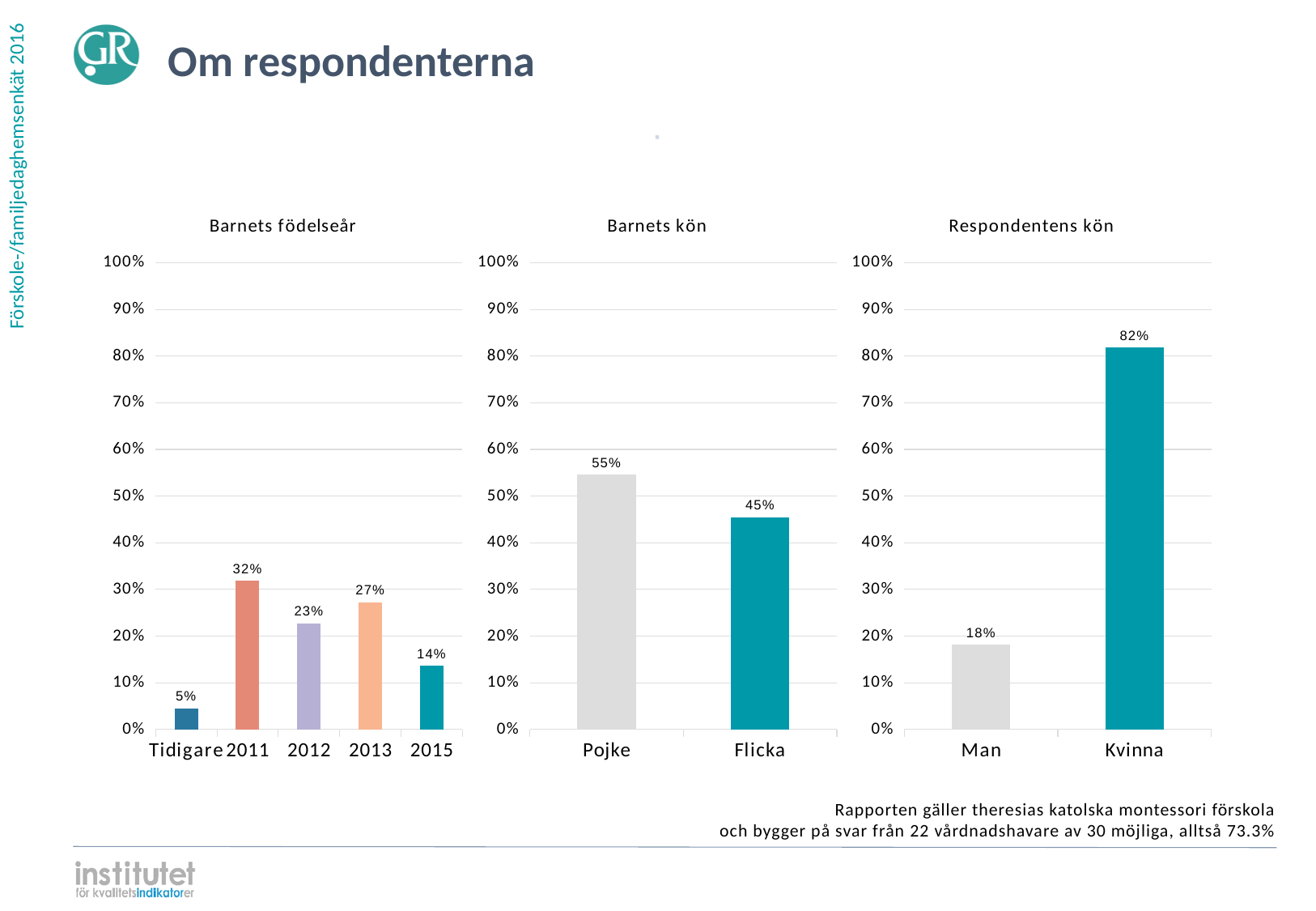
In the 'Barnets kön' chart, which is larger, Pojke or Flicka? Pojke In the 'Barnets födelseår' chart, what is the value for 2011? 32% In the 'Respondentens kön' chart, is the value for Man greater or less than 20%? less In the 'Barnets födelseår' chart, which category has the highest value? 2011 In the 'Barnets födelseår' chart, which category has the lowest value? Tidigare In the 'Barnets kön' chart, what is the value for Pojke? 55% In the 'Barnets födelseår' chart, what is the difference between the values for 2013 and 2015? 13% In the 'Respondentens kön' chart, what is the value for Kvinna? 82% In the 'Barnets födelseår' chart, how many categories are shown on the x axis? 5 In the 'Barnets kön' chart, what is the difference between Pojke and Flicka? 10% How many charts are shown on the slide? 3 What kind of chart is the 'Respondentens kön' chart? Bar chart